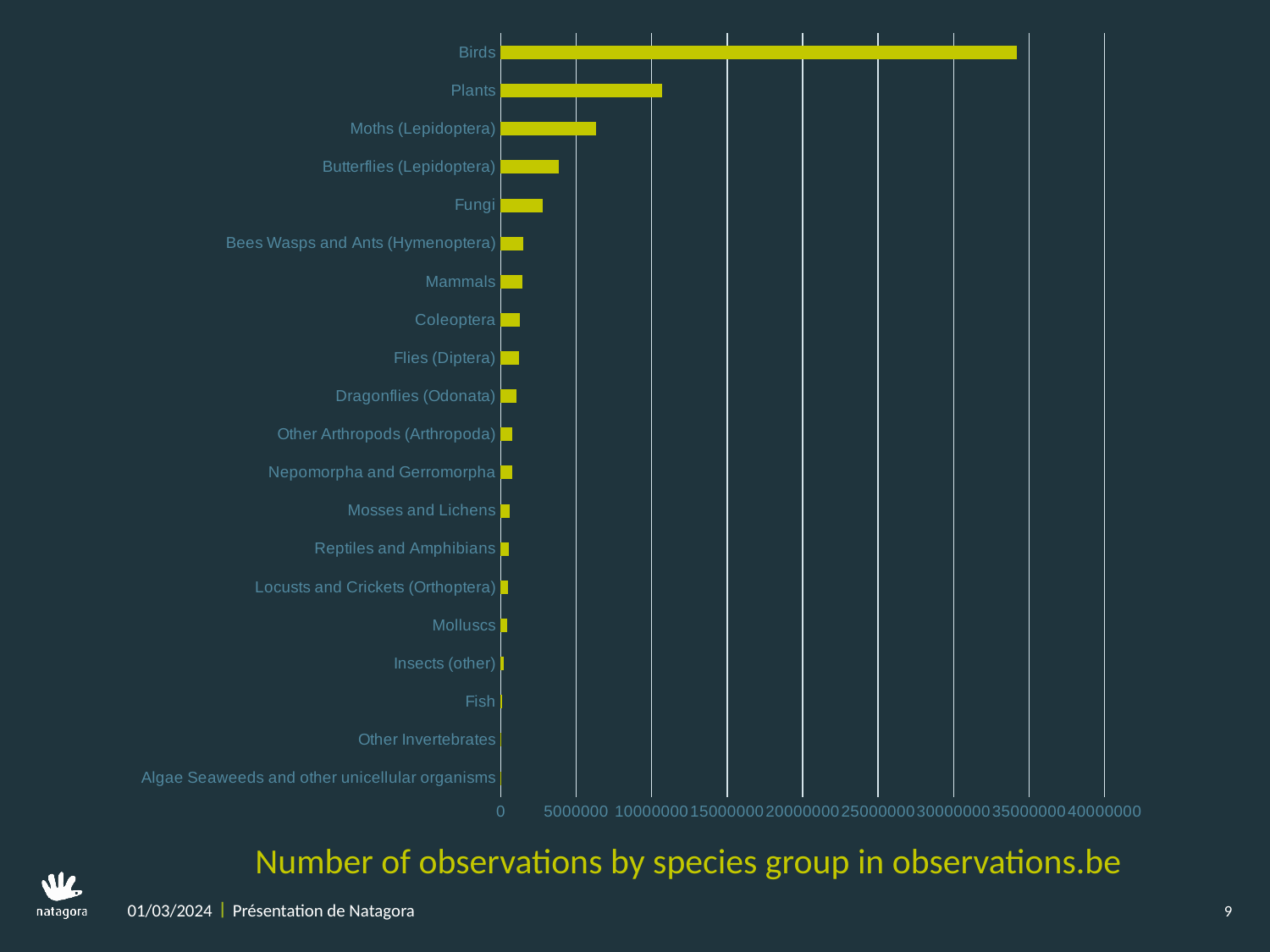
How many species groups are listed on the chart? 20 Which has more observations, Fungi or Mammals? Fungi Is the value for Birds greater or less than 30000000? greater Which has more observations, Moths (Lepidoptera) or Butterflies (Lepidoptera)? Moths (Lepidoptera) What kind of chart is shown on the slide? bar chart Is the value for Birds greater or less than 40000000? less Is the value for Moths (Lepidoptera) greater or less than 10000000? less What is the title of the chart? Number of observations by species group in observations.be Which has more observations, Birds or Plants? Birds Which species group has the highest number of observations? Birds